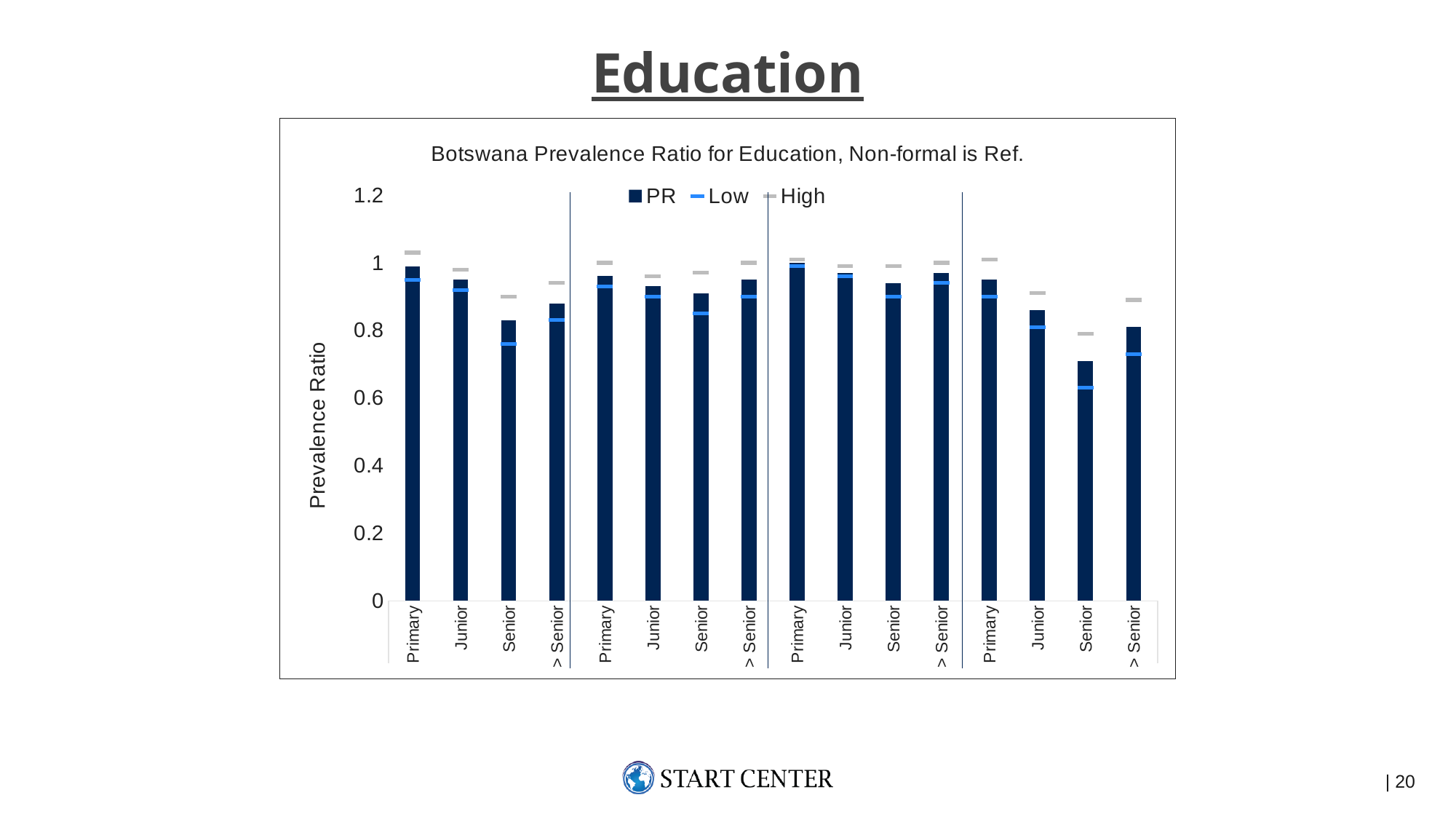
Is the PR value for Primary in the leftmost group greater or less than 0.8? greater In the rightmost group, which has the larger PR value, Primary or Senior? Primary In the rightmost group, do the PR values rise or fall from Primary to Senior? fall What is the label on the vertical axis of the chart? Prevalence Ratio Which bar has the lowest PR value in the chart? Senior in the rightmost group How many series does the chart legend list? 3 Is the PR value for Senior in the rightmost group greater or less than 0.8? less How many bars are plotted in the chart? 16 What is the title of the chart? Botswana Prevalence Ratio for Education, Non-formal is Ref. What kind of chart is shown on the slide? Bar chart Is the PR value for Junior in the rightmost group greater or less than 1? less Which has the larger PR value, Senior in the leftmost group or Senior in the second group from the left? Senior in the second group from the left